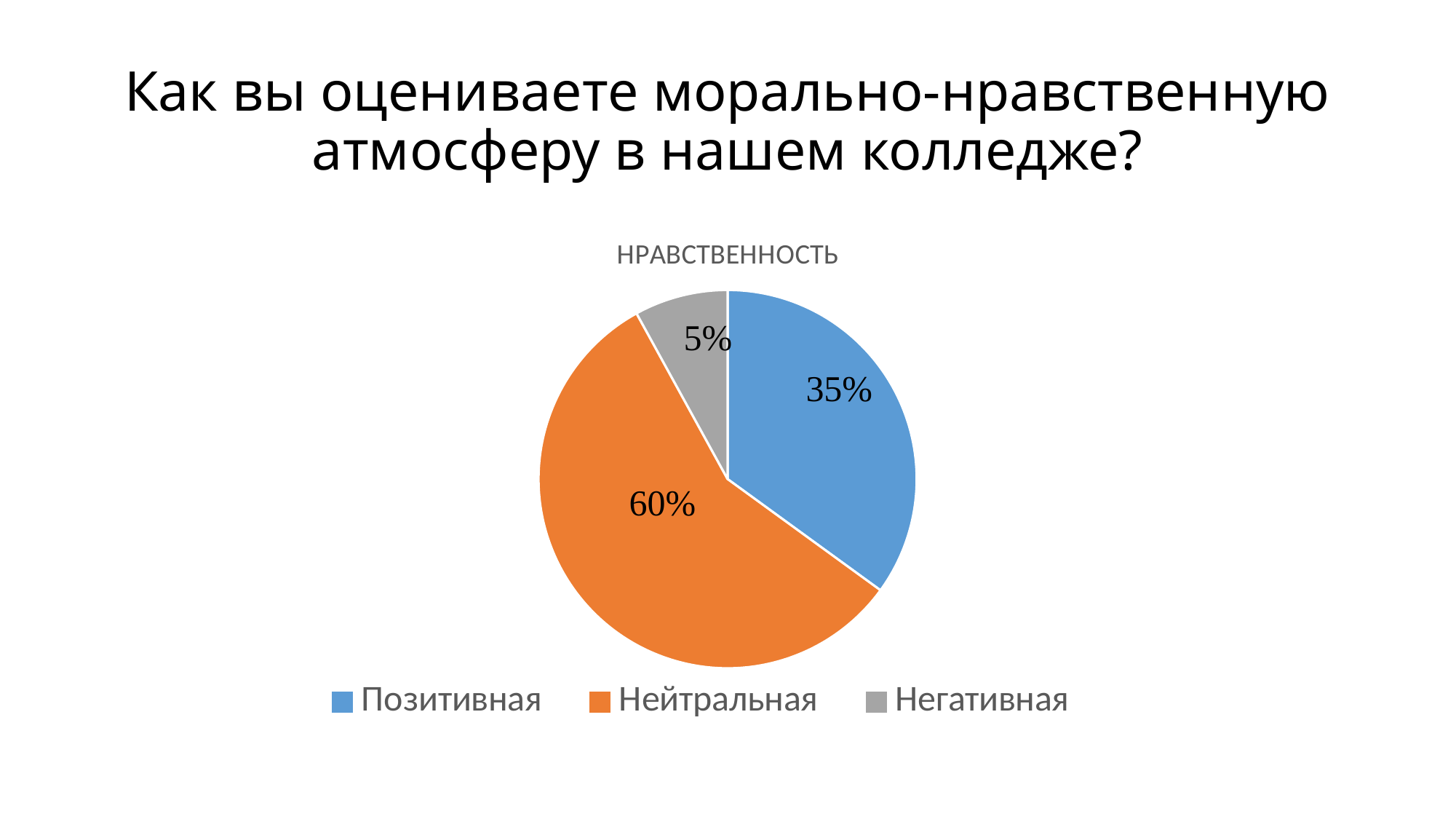
What share of the pie does Нейтральная take? 60% How many categories does the pie chart have? 3 What share of the pie does Негативная take? 5% What is the title of the chart? НРАВСТВЕННОСТЬ Which is larger, the share of Позитивная or the share of Негативная? Позитивная What is the difference between the shares of Нейтральная and Позитивная? 25% What type of chart is shown on the slide? pie chart Which category has the smallest slice? Негативная What share of the pie does Позитивная take? 35% What is the difference between the shares of Позитивная and Негативная? 30% What colour is the slice for Нейтральная? orange Which category has the largest slice? Нейтральная